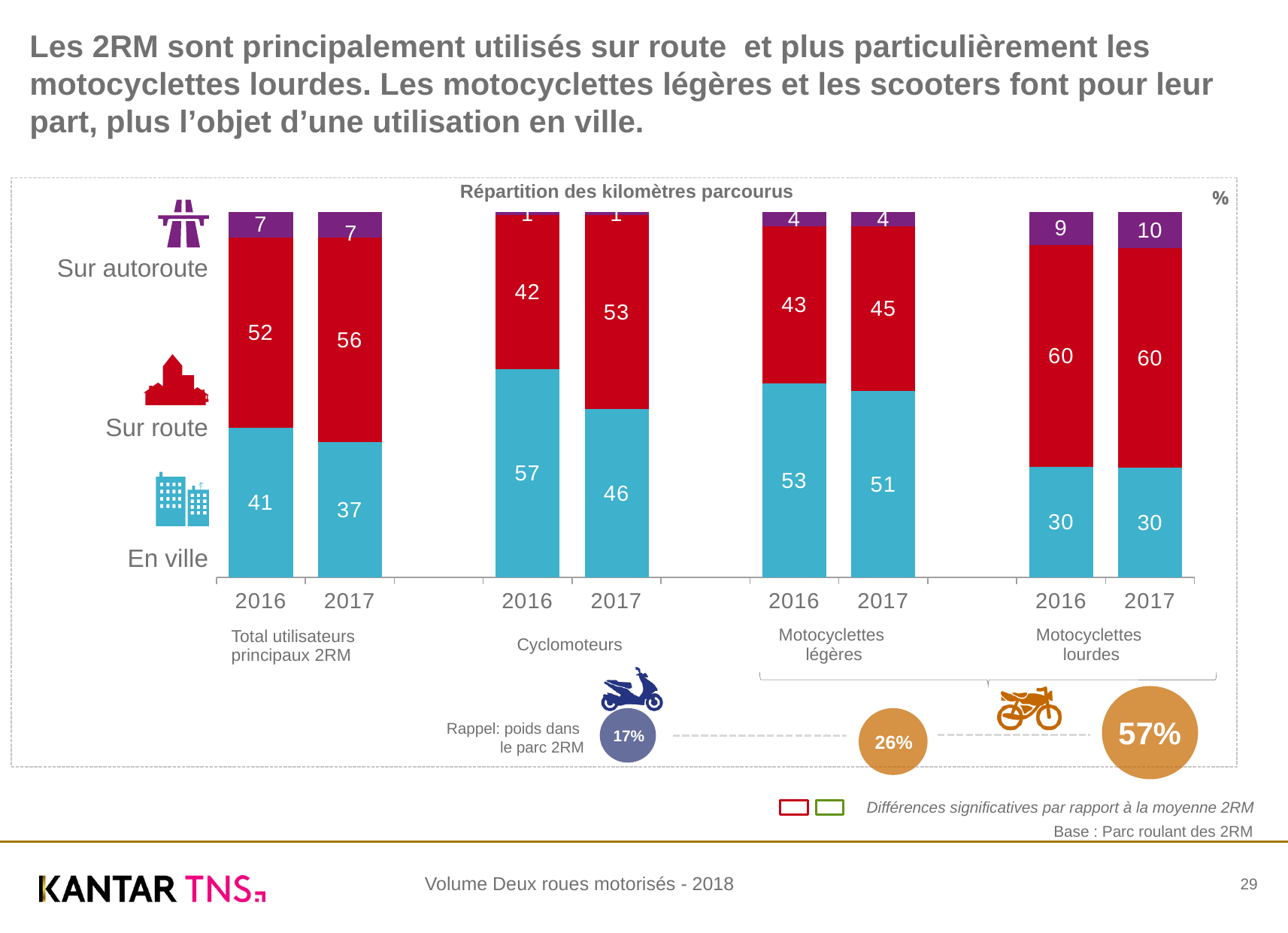
What is the title of the chart? Répartition des kilomètres parcourus How many bars are plotted in the chart? 8 How does the 'En ville' value for Total utilisateurs principaux 2RM change from 2016 to 2017? It falls from 41 to 37 Which is larger for Motocyclettes légères in 2017: the 'En ville' value or the 'Sur route' value? En ville What is the 'Sur autoroute' value for Motocyclettes lourdes in 2017? 10 Which category has the highest 'Sur autoroute' value in 2017? Motocyclettes lourdes What is the 'En ville' value for Cyclomoteurs in 2016? 57 Which category has the lowest 'En ville' value in 2016? Motocyclettes lourdes How many series (road types) does the chart show? 3 What kind of chart is shown on the slide? stacked bar chart What is the difference between the 'Sur route' values for Cyclomoteurs in 2017 and 2016? 11 What is the 'Sur route' value for Motocyclettes lourdes in 2017? 60